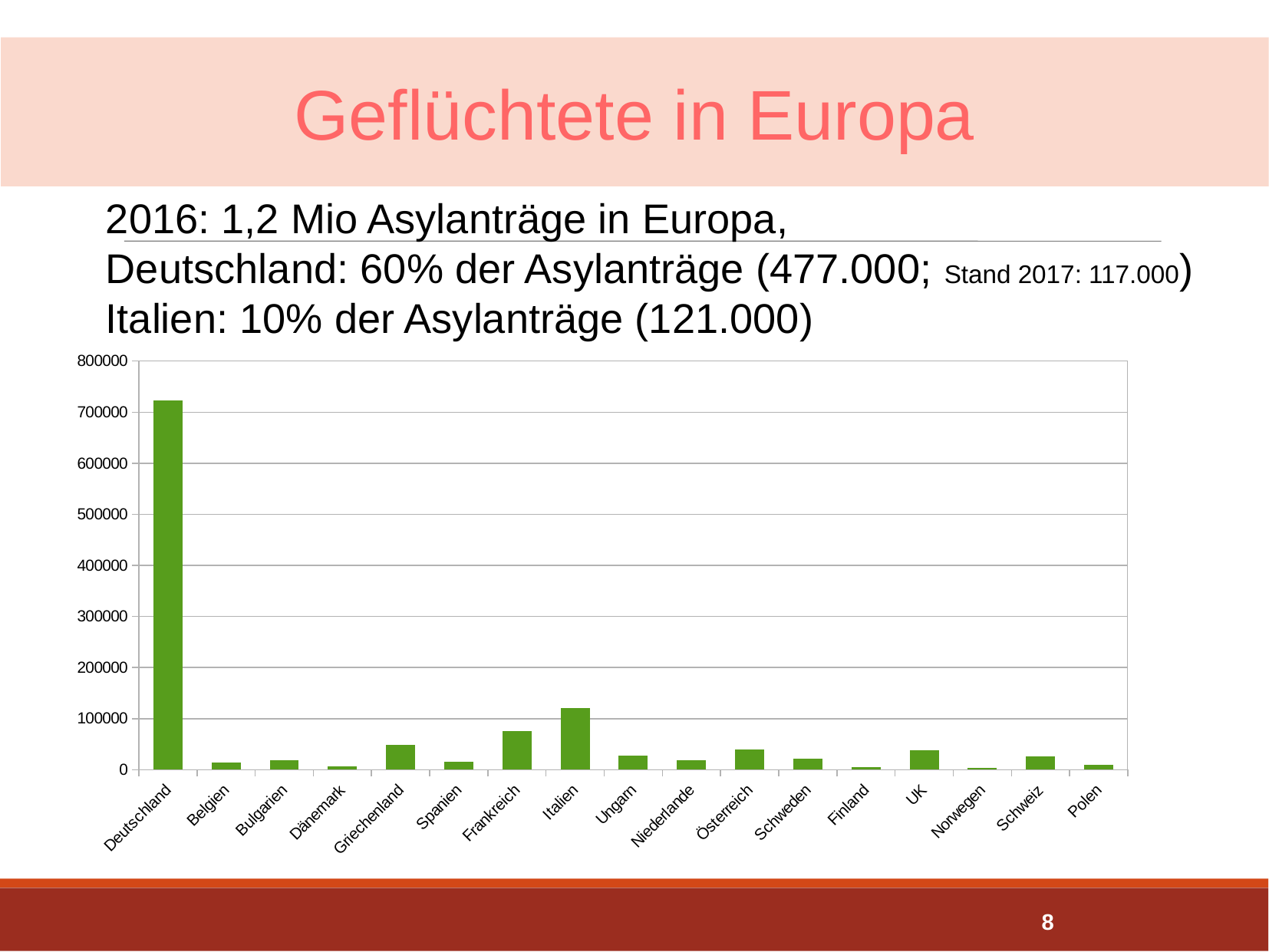
Which has the larger value, Italien or Frankreich? Italien Which has the larger value, Griechenland or Spanien? Griechenland Which country has the second-highest bar in the chart? Italien What colour are the bars in the chart? green What kind of chart is shown on the slide? bar chart Is the value for Italien greater or less than 200000? less Is the value for Deutschland greater or less than 600000? greater How many countries are shown on the x axis of the chart? 17 Is the value for Frankreich greater or less than 100000? less Which has the larger value, Schweiz or Polen? Schweiz Which country has the highest bar in the chart? Deutschland